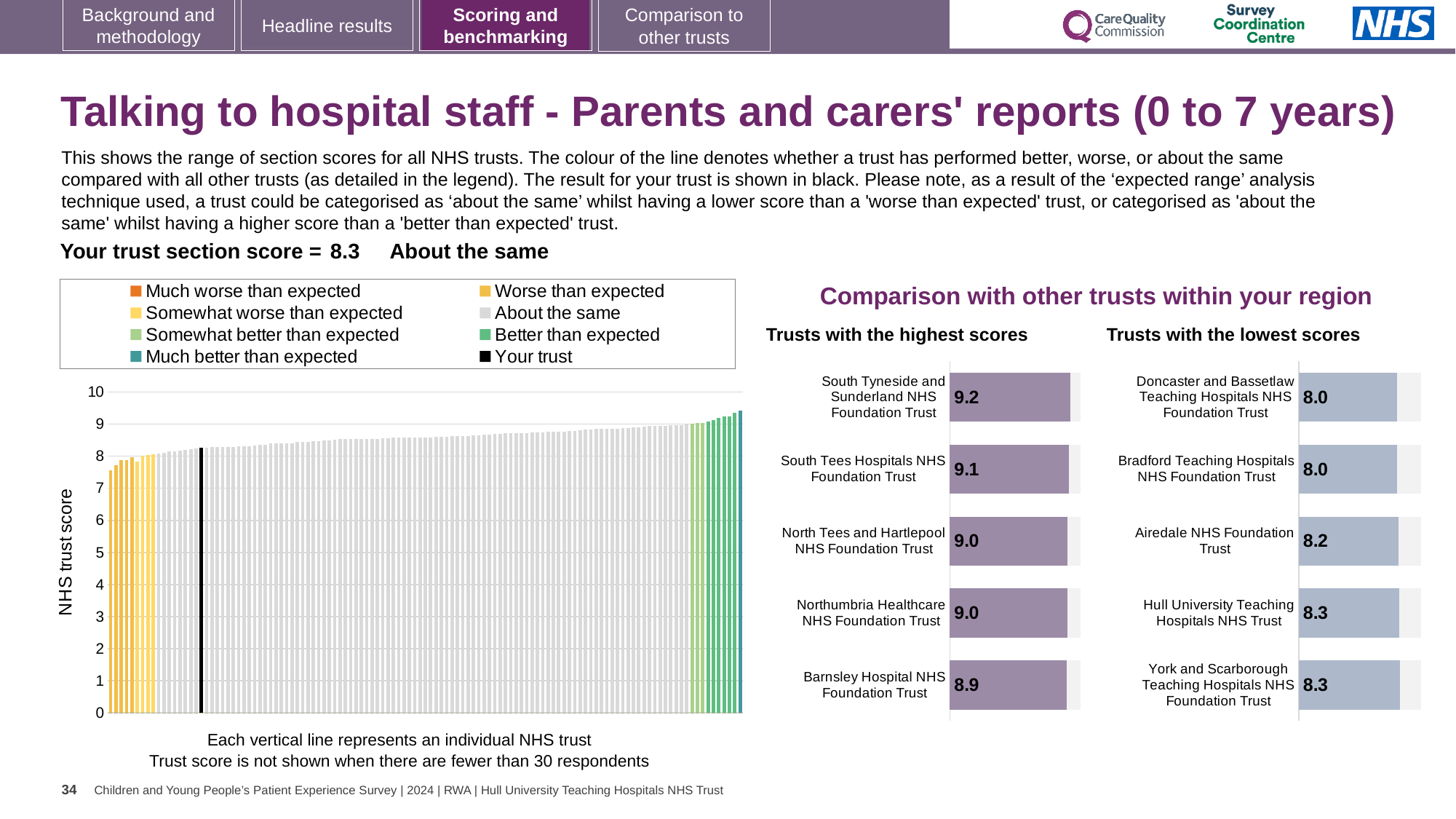
In the 'Trusts with the highest scores' chart, what is the score for Barnsley Hospital NHS Foundation Trust? 8.9 In the 'Trusts with the highest scores' chart, what is the difference between the scores of South Tyneside and Sunderland NHS Foundation Trust and Barnsley Hospital NHS Foundation Trust? 0.3 What kind of chart is the large chart on the left showing all NHS trusts? Bar chart In the 'Trusts with the lowest scores' chart, what is the score for Airedale NHS Foundation Trust? 8.2 In the 'Trusts with the lowest scores' chart, which trust has a higher score: Airedale NHS Foundation Trust or Bradford Teaching Hospitals NHS Foundation Trust? Airedale NHS Foundation Trust In the 'Trusts with the highest scores' chart, which trust has the highest score? South Tyneside and Sunderland NHS Foundation Trust In the 'Trusts with the lowest scores' chart, what is the difference between the scores of Hull University Teaching Hospitals NHS Trust and Doncaster and Bassetlaw Teaching Hospitals NHS Foundation Trust? 0.3 How many entries does the legend of the large chart on the left list? 8 In the 'Trusts with the highest scores' chart, what is the score for South Tyneside and Sunderland NHS Foundation Trust? 9.2 How many trusts are shown in the 'Trusts with the highest scores' chart? 5 In the large chart on the left, do the trust scores rise or fall from left to right? Rise In the 'Trusts with the lowest scores' chart, what is the score for York and Scarborough Teaching Hospitals NHS Foundation Trust? 8.3